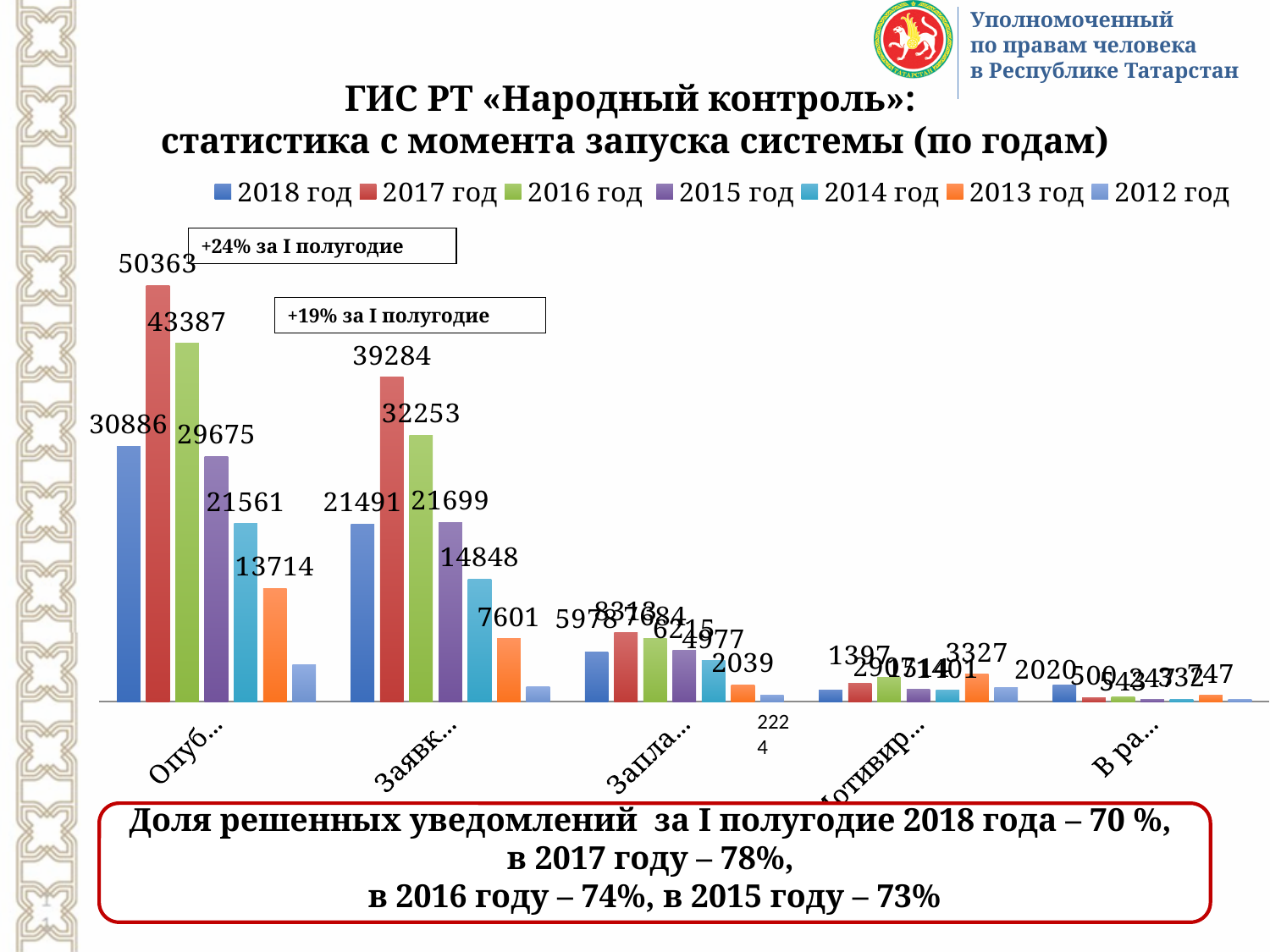
In the second category group (Заявк...), what is the value for 2014 год? 14848 In the first category group (Опуб...), which year has the highest value? 2017 год How many series does the legend list? 7 In the first category group (Опуб...), what is the value for 2017 год? 50363 In the first category group (Опуб...), what is the value for 2013 год? 13714 What does the annotation box above the first category group say? +24% за I полугодие In the second category group (Заявк...), what is the value for 2017 год? 39284 In the first category group (Опуб...), what is the value for 2018 год? 30886 What type of chart is shown on the slide? bar chart In the second category group (Заявк...), which is larger: the value for 2016 год or the value for 2015 год? 2016 год In the first category group (Опуб...), what is the difference between the 2017 год value and the 2016 год value? 6976 How many category groups are plotted along the x axis? 5